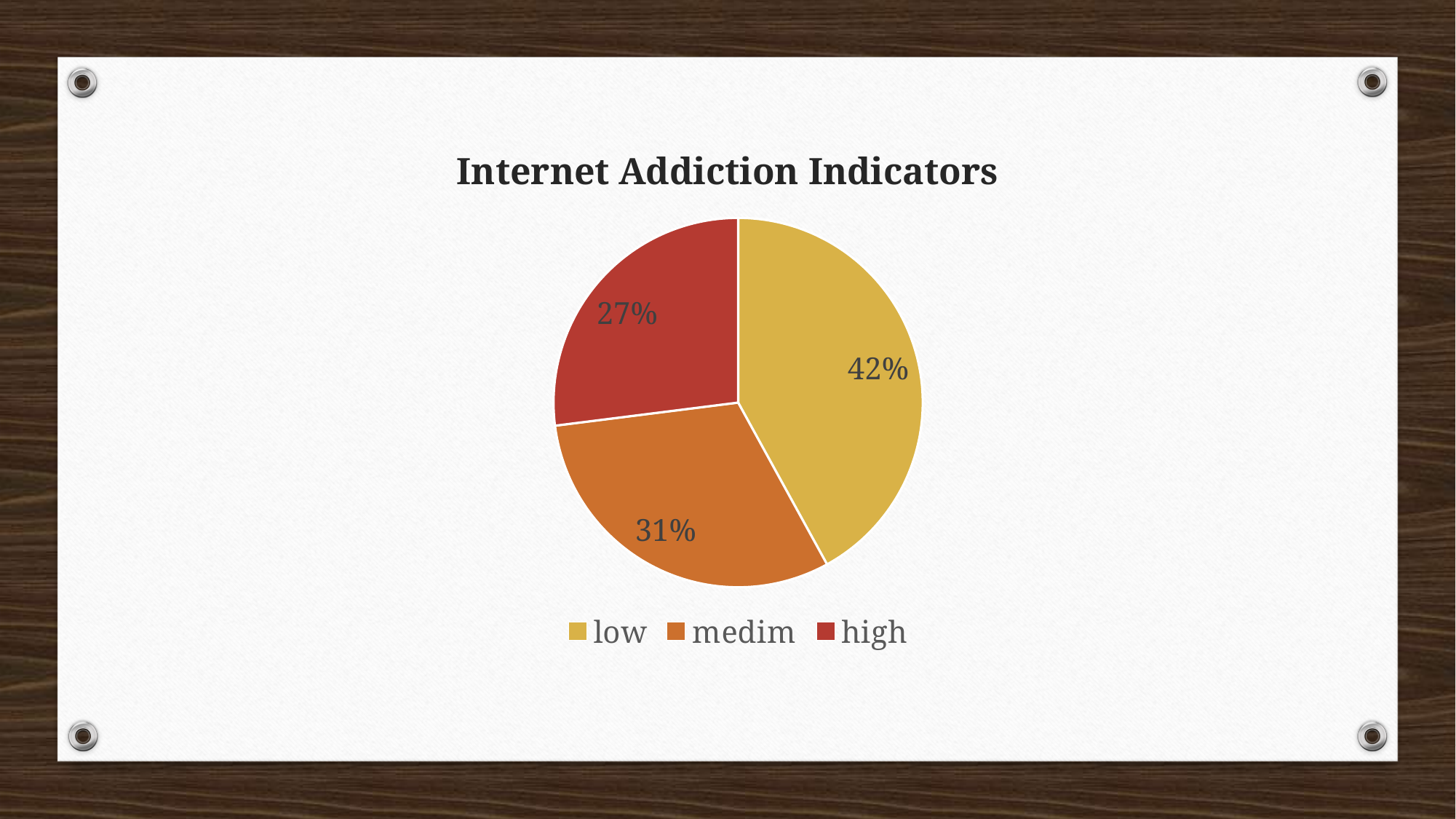
What percentage is shown for the high slice? 27% What kind of chart is shown on the slide? pie chart Which category has the largest slice of the pie? low What is the difference in percentage points between the medim and high slices? 4 Which category has the smallest slice of the pie? high What colour is the slice for high? red What is the difference in percentage points between the low and high slices? 15 What percentage is shown for the medim slice? 31% How many slices does the pie chart have? 3 Which is larger, the low slice or the medim slice? low What percentage is shown for the low slice? 42% What is the title of the chart? Internet Addiction Indicators